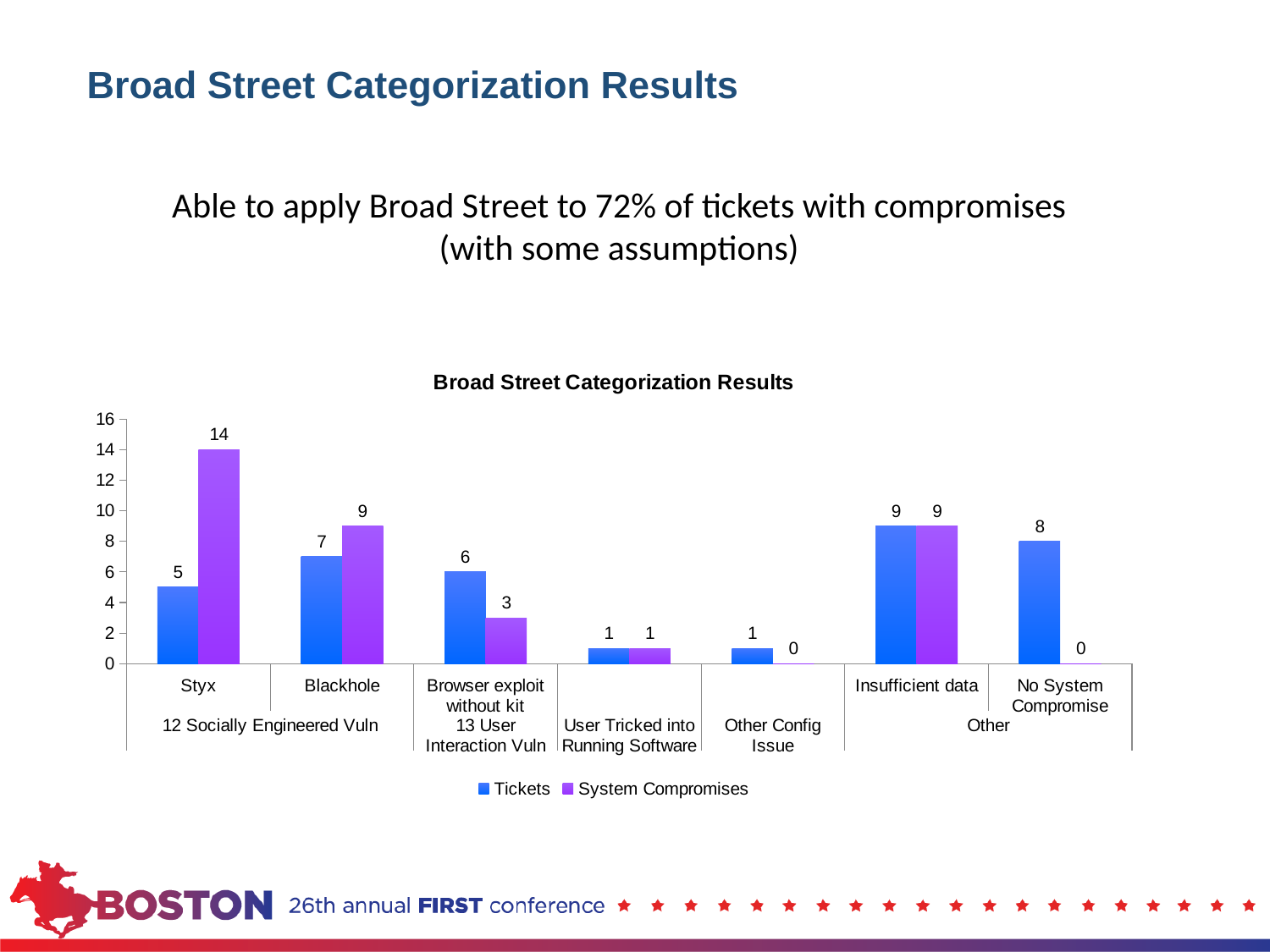
How many categories are shown on the x axis? 7 Which category has the highest Tickets value? Insufficient data What is the System Compromises value for Browser exploit without kit? 3 What is the Tickets value for Styx? 5 How many series does the legend list? 2 What is the Tickets value for Blackhole? 7 What kind of chart is shown? Bar chart What is the Tickets value for No System Compromise? 8 Which is larger for Browser exploit without kit, Tickets or System Compromises? Tickets What is the difference between the System Compromises and Tickets values for Styx? 9 What is the System Compromises value for Styx? 14 Which category has the highest System Compromises value? Styx